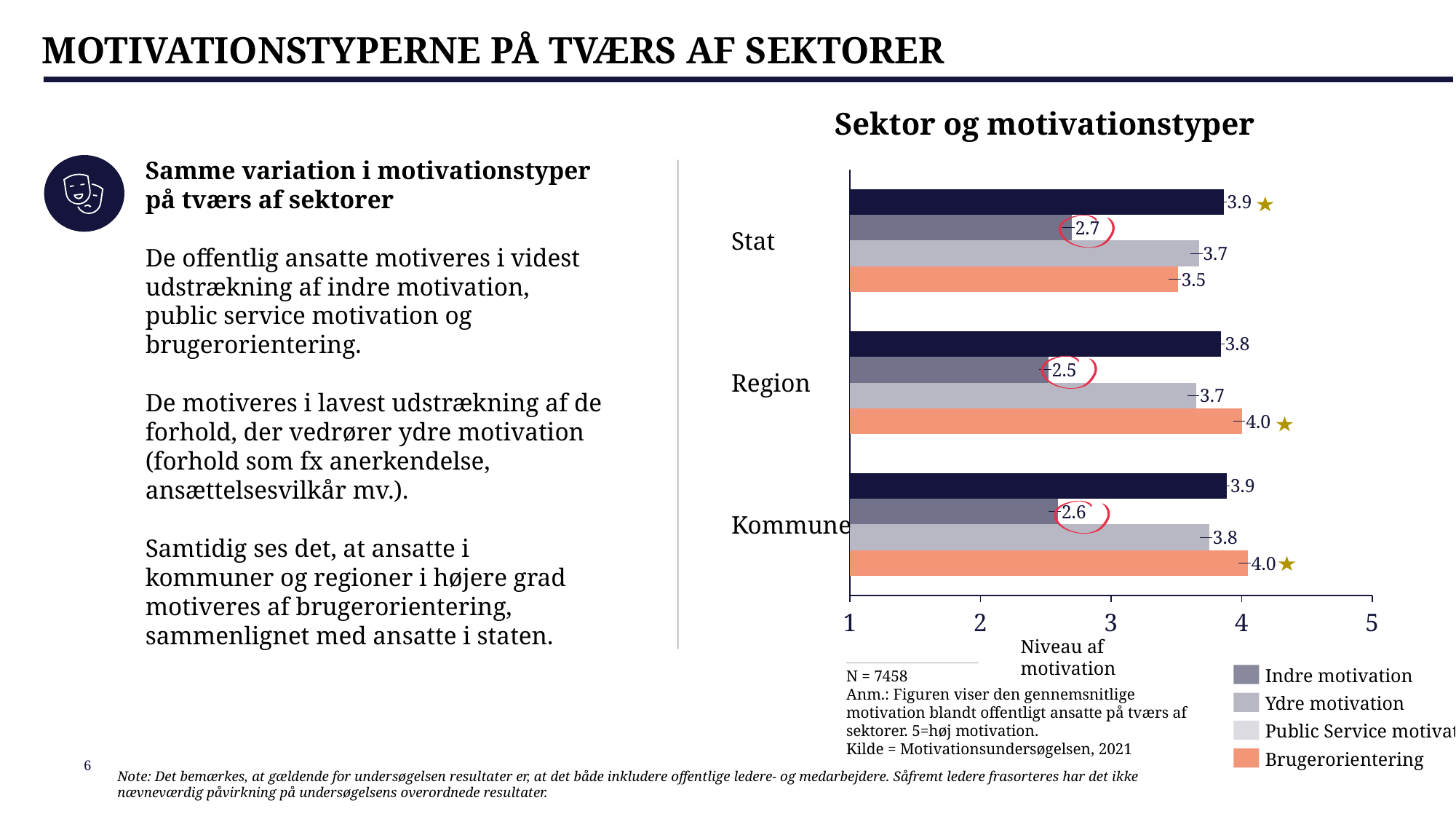
How many sector categories are shown on the chart? 3 Which motivation type has the highest value in the Stat category? Indre motivation What kind of chart is shown on the slide? Bar chart Which motivation type has the lowest value in the Kommune category? Ydre motivation What is the title of the chart? Sektor og motivationstyper What is the difference between Indre motivation and Ydre motivation in the Region category? 1.3 What is the value for Indre motivation in the Region category? 3.8 What is the value for Brugerorientering in the Region category? 4.0 What is the value for Ydre motivation in the Stat category? 2.7 How many series does the legend list? 4 Which is larger: Brugerorientering for Stat or Brugerorientering for Kommune? Brugerorientering for Kommune What is the value for Public Service motivation in the Kommune category? 3.8